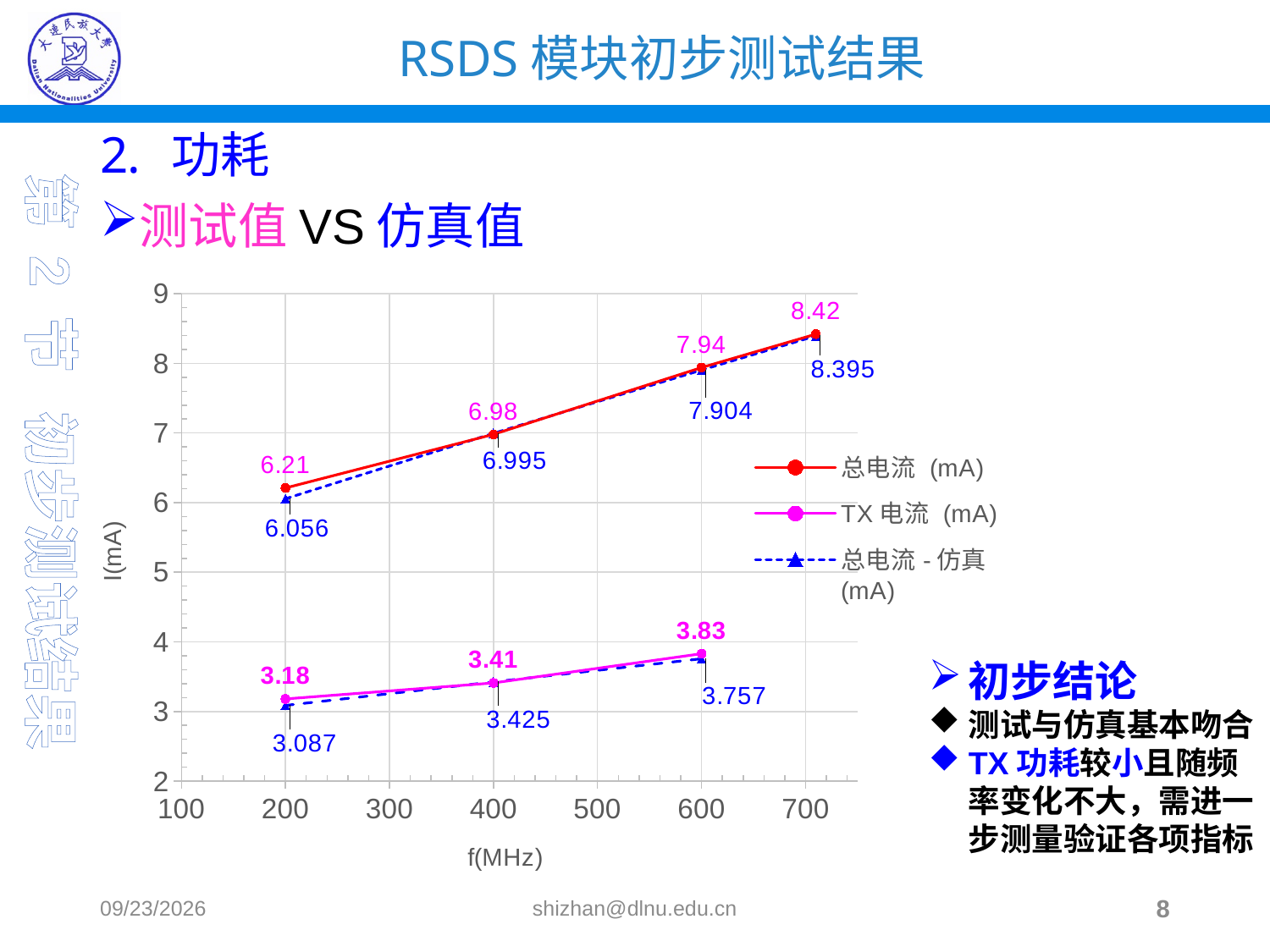
How many data points are plotted for the TX 电流 (mA) series? 3 What is the label of the x axis? f(MHz) What is the highest labelled value of the 总电流 (mA) series? 8.42 At 600 MHz, which is larger: 总电流 (mA) or TX 电流 (mA)? 总电流 (mA) What is the value of TX 电流 (mA) at 600 MHz? 3.83 What is the difference between 总电流 (mA) and 总电流 - 仿真 (mA) at 200 MHz? 0.154 What is the value of 总电流 - 仿真 (mA) at 400 MHz? 6.995 What is the lowest labelled value of the TX 电流 (mA) series? 3.18 Does the 总电流 (mA) series rise or fall as frequency increases? rise How many series does the legend list? 3 What is the value of 总电流 (mA) at 200 MHz? 6.21 What kind of chart is shown on the slide? line chart